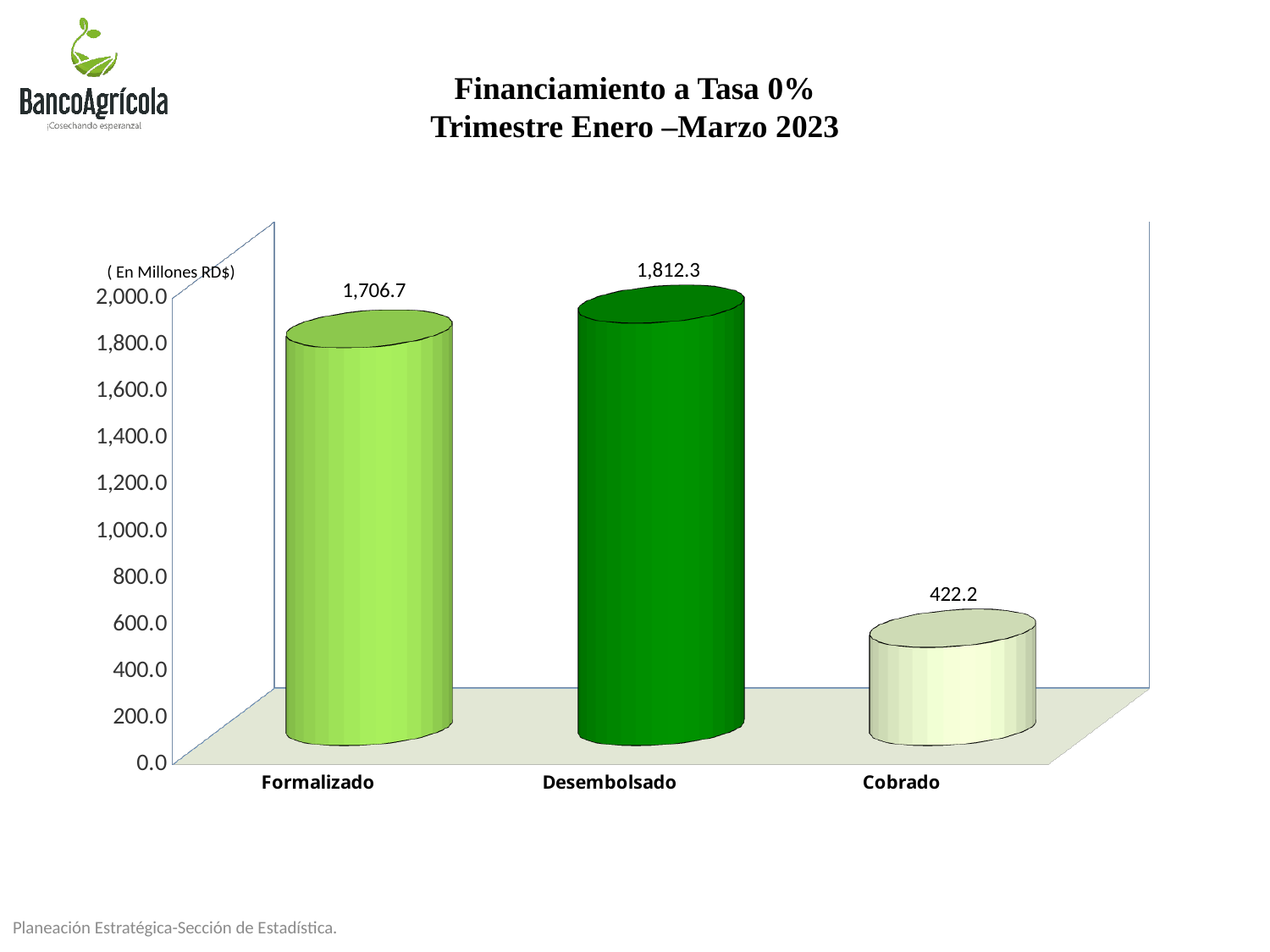
What kind of chart is shown on the slide? bar chart What is the difference between the values for Desembolsado and Formalizado? 105.6 Which category has the highest value? Desembolsado Which is larger, the value for Formalizado or the value for Cobrado? Formalizado What is the difference between the values for Formalizado and Cobrado? 1,284.5 Is the value for Cobrado greater or less than 600.0? less Which category has the lowest value? Cobrado What is the value for Cobrado? 422.2 What is the value for Formalizado? 1,706.7 What unit is stated for the values in the chart? En Millones RD$ How many categories are shown in the chart? 3 What is the value for Desembolsado? 1,812.3